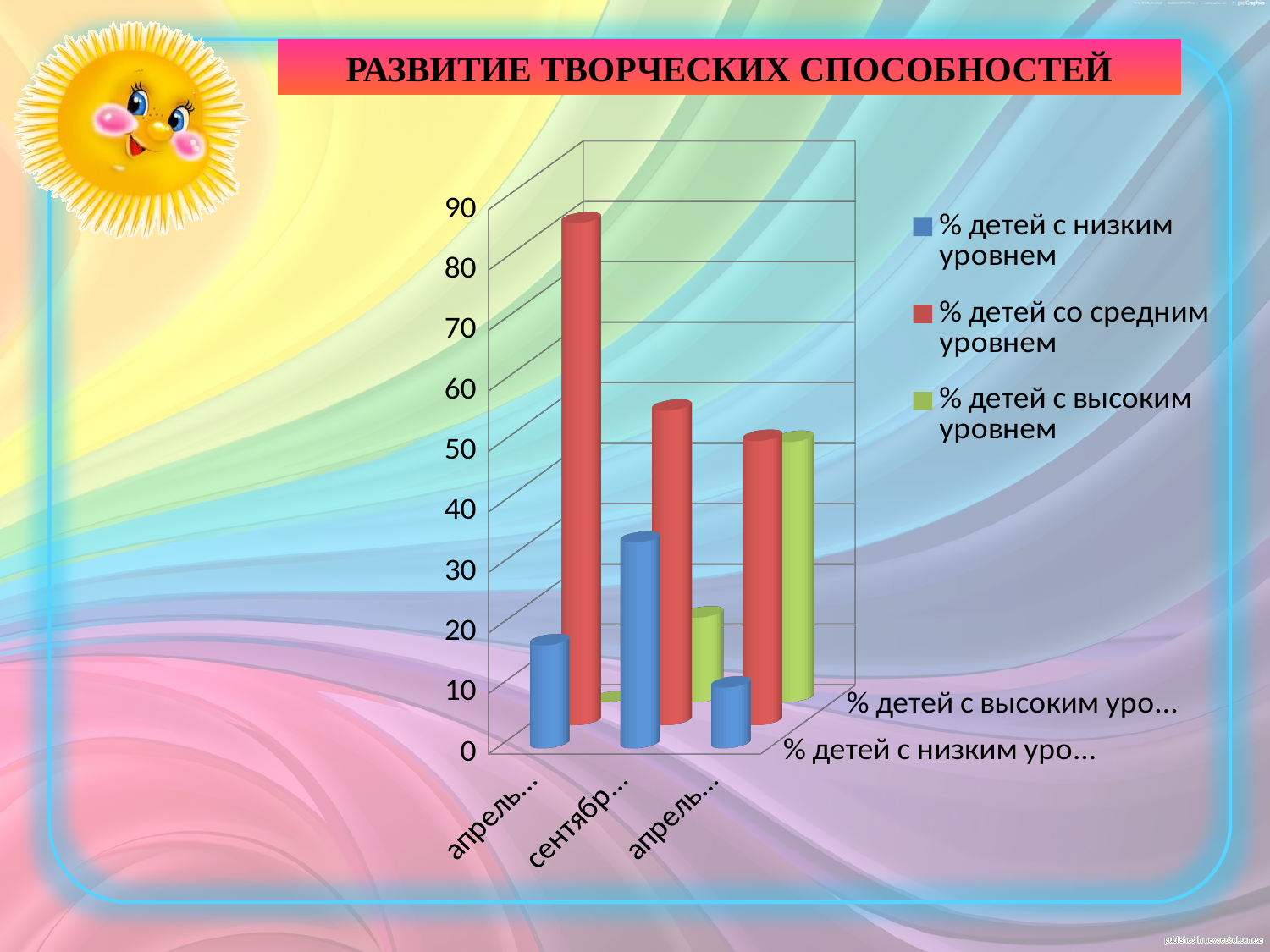
In the third group of bars, which is larger: '% детей с низким уровнем' or '% детей со средним уровнем'? % детей со средним уровнем Do the values for '% детей с высоким уровнем' rise or fall from the first group to the third group along the x axis? rise Which series has the tallest bar in the first group of bars (апрель...)? % детей со средним уровнем Which series has the lowest bar in the first group of bars (апрель...)? % детей с высоким уровнем Is the value for '% детей с высоким уровнем' in the third group of bars greater or less than 40? greater Which colour represents the series '% детей со средним уровнем' in the legend? red Is the value for '% детей со средним уровнем' in the first group of bars greater or less than 80? greater How many series does the legend list? 3 What is the title of the slide above the chart? РАЗВИТИЕ ТВОРЧЕСКИХ СПОСОБНОСТЕЙ Is the value for '% детей с низким уровнем' in the third group of bars greater or less than 20? less How many groups of bars (categories) are plotted along the x axis? 3 What kind of chart is shown on the slide? bar chart